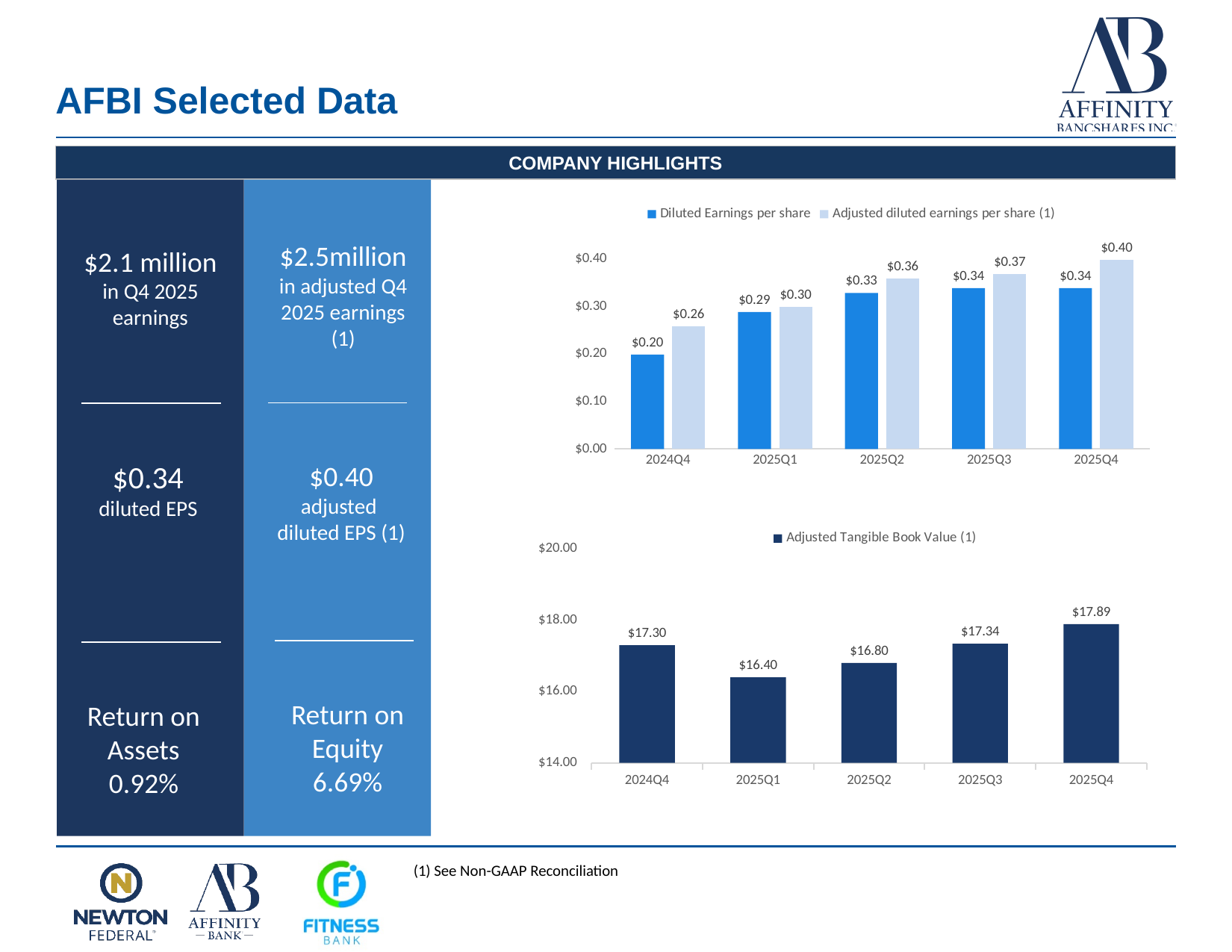
In the top chart (earnings per share), does Diluted Earnings per share generally rise or fall from 2024Q4 to 2025Q4? rise In the bottom chart (Adjusted Tangible Book Value), what is the difference between 2025Q4 and 2024Q4? $0.59 In the top chart (earnings per share), what is the difference between Adjusted diluted earnings per share and Diluted Earnings per share for 2025Q4? $0.06 In the bottom chart (Adjusted Tangible Book Value), how many quarters are shown on the x axis? 5 In the top chart (earnings per share), what is the Diluted Earnings per share value for 2024Q4? $0.20 In the top chart (earnings per share), how many series does the legend list? 2 What kind of chart is the bottom chart (Adjusted Tangible Book Value)? bar chart In the bottom chart (Adjusted Tangible Book Value), which quarter has the lowest value? 2025Q1 In the top chart (earnings per share), which quarter has the highest Adjusted diluted earnings per share? 2025Q4 In the top chart (earnings per share), what is the Adjusted diluted earnings per share value for 2025Q4? $0.40 In the top chart (earnings per share), which quarter has the lowest Diluted Earnings per share? 2024Q4 In the bottom chart (Adjusted Tangible Book Value), what is the value for 2025Q2? $16.80